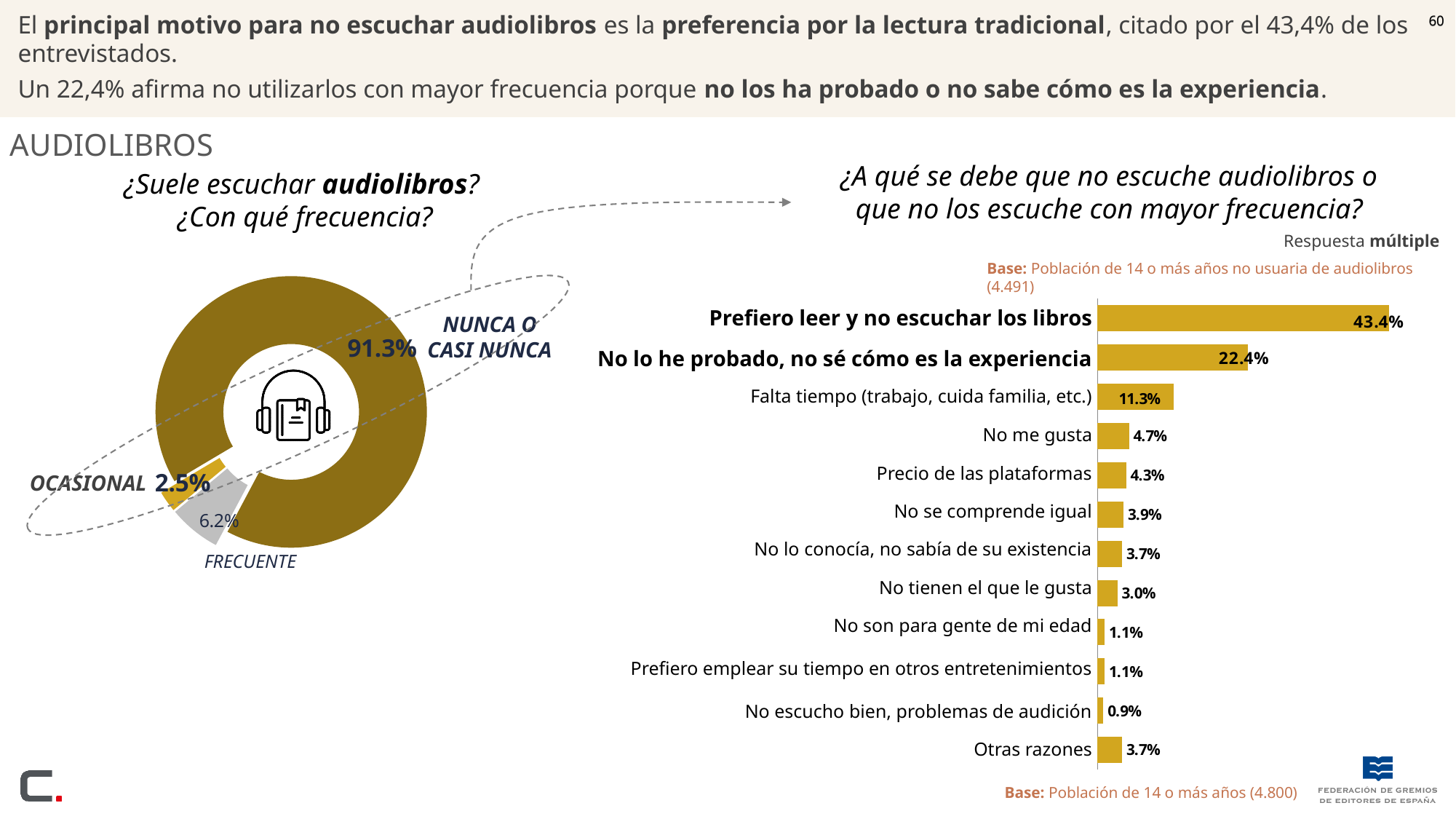
In the chart '¿Suele escuchar audiolibros? ¿Con qué frecuencia?', what percentage is shown for NUNCA O CASI NUNCA? 91.3% In the chart '¿Suele escuchar audiolibros? ¿Con qué frecuencia?', how many categories are shown? 3 In the chart '¿A qué se debe que no escuche audiolibros o que no los escuche con mayor frecuencia?', how many reasons are listed? 12 In the chart '¿A qué se debe que no escuche audiolibros o que no los escuche con mayor frecuencia?', which reason has the lowest value? No escucho bien, problemas de audición In the chart '¿A qué se debe que no escuche audiolibros o que no los escuche con mayor frecuencia?', which reason has the highest value? Prefiero leer y no escuchar los libros In the chart '¿Suele escuchar audiolibros? ¿Con qué frecuencia?', which category has the smallest share? OCASIONAL In the chart '¿A qué se debe que no escuche audiolibros o que no los escuche con mayor frecuencia?', what is the difference between 'Prefiero leer y no escuchar los libros' and 'No lo he probado, no sé cómo es la experiencia'? 21.0% What kind of chart is used for '¿Suele escuchar audiolibros? ¿Con qué frecuencia?'? Pie (donut) chart In the chart '¿A qué se debe que no escuche audiolibros o que no los escuche con mayor frecuencia?', what is the value for 'Precio de las plataformas'? 4.3% In the chart '¿A qué se debe que no escuche audiolibros o que no los escuche con mayor frecuencia?', what is the value for 'Falta tiempo (trabajo, cuida familia, etc.)'? 11.3% In the chart '¿A qué se debe que no escuche audiolibros o que no los escuche con mayor frecuencia?', which is larger: 'No me gusta' or 'No se comprende igual'? No me gusta In the chart '¿Suele escuchar audiolibros? ¿Con qué frecuencia?', what percentage is shown for FRECUENTE? 6.2%